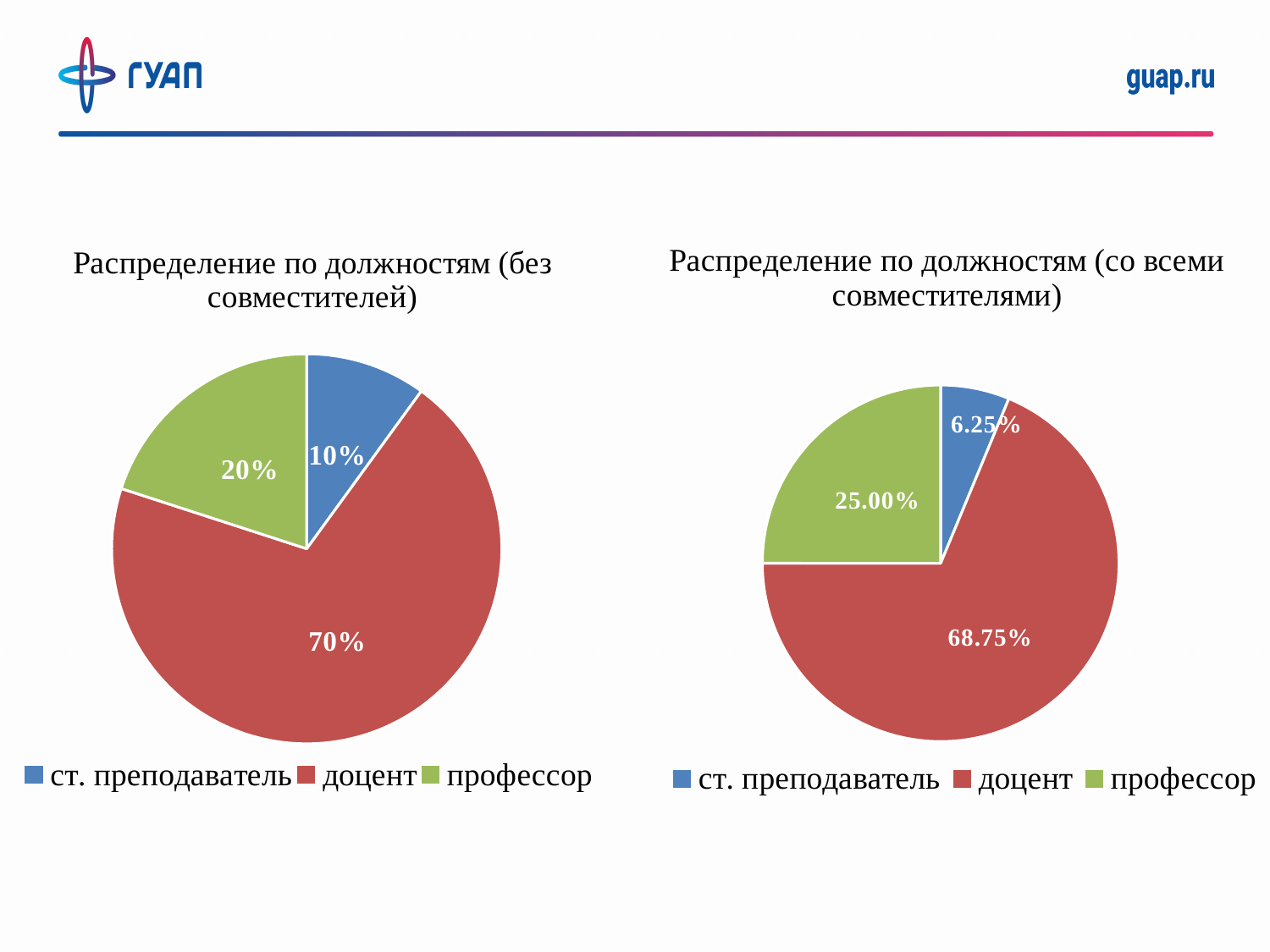
In the left chart (Распределение по должностям (без совместителей)), what share is shown for профессор? 20% In the left chart (Распределение по должностям (без совместителей)), what is the difference between the shares for доцент and профессор? 50% In the right chart (Распределение по должностям (со всеми совместителями)), what share is shown for профессор? 25.00% In the left chart (Распределение по должностям (без совместителей)), what share is shown for доцент? 70% In the right chart (Распределение по должностям (со всеми совместителями)), what share is shown for ст. преподаватель? 6.25% How many categories does the legend of the right chart (Распределение по должностям (со всеми совместителями)) list? 3 In the right chart (Распределение по должностям (со всеми совместителями)), what share is shown for доцент? 68.75% In the left chart (Распределение по должностям (без совместителей)), which category has the largest slice? доцент In the right chart (Распределение по должностям (со всеми совместителями)), which is larger: the share for профессор or the share for ст. преподаватель? профессор In the right chart (Распределение по должностям (со всеми совместителями)), which category has the smallest slice? ст. преподаватель In the left chart (Распределение по должностям (без совместителей)), what share is shown for ст. преподаватель? 10% What type of chart is the left chart (Распределение по должностям (без совместителей))? pie chart